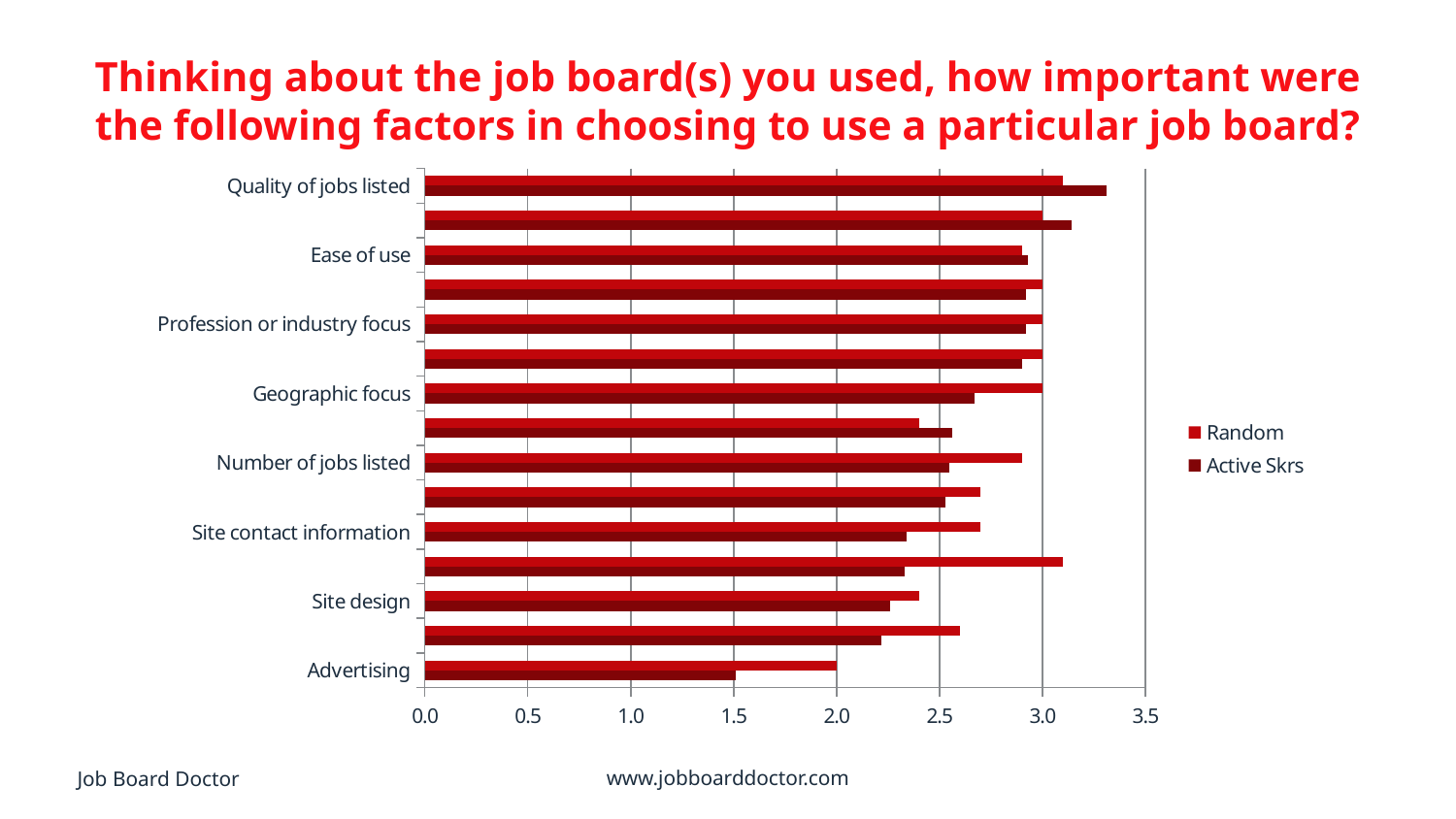
Is the Random value for Advertising greater or less than 2.5? less What are the two series named in the legend? Random and Active Skrs How many series does the legend list? 2 For Quality of jobs listed, which series has the larger value, Random or Active Skrs? Active Skrs Is the Active Skrs value for Quality of jobs listed greater or less than 3.0? greater What kind of chart is shown on the slide? bar chart Which labelled factor has the lowest Active Skrs value? Advertising Which labelled factor has the highest Active Skrs value? Quality of jobs listed Is the Random value for Number of jobs listed greater or less than 2.5? greater For Advertising, which series has the larger value, Random or Active Skrs? Random